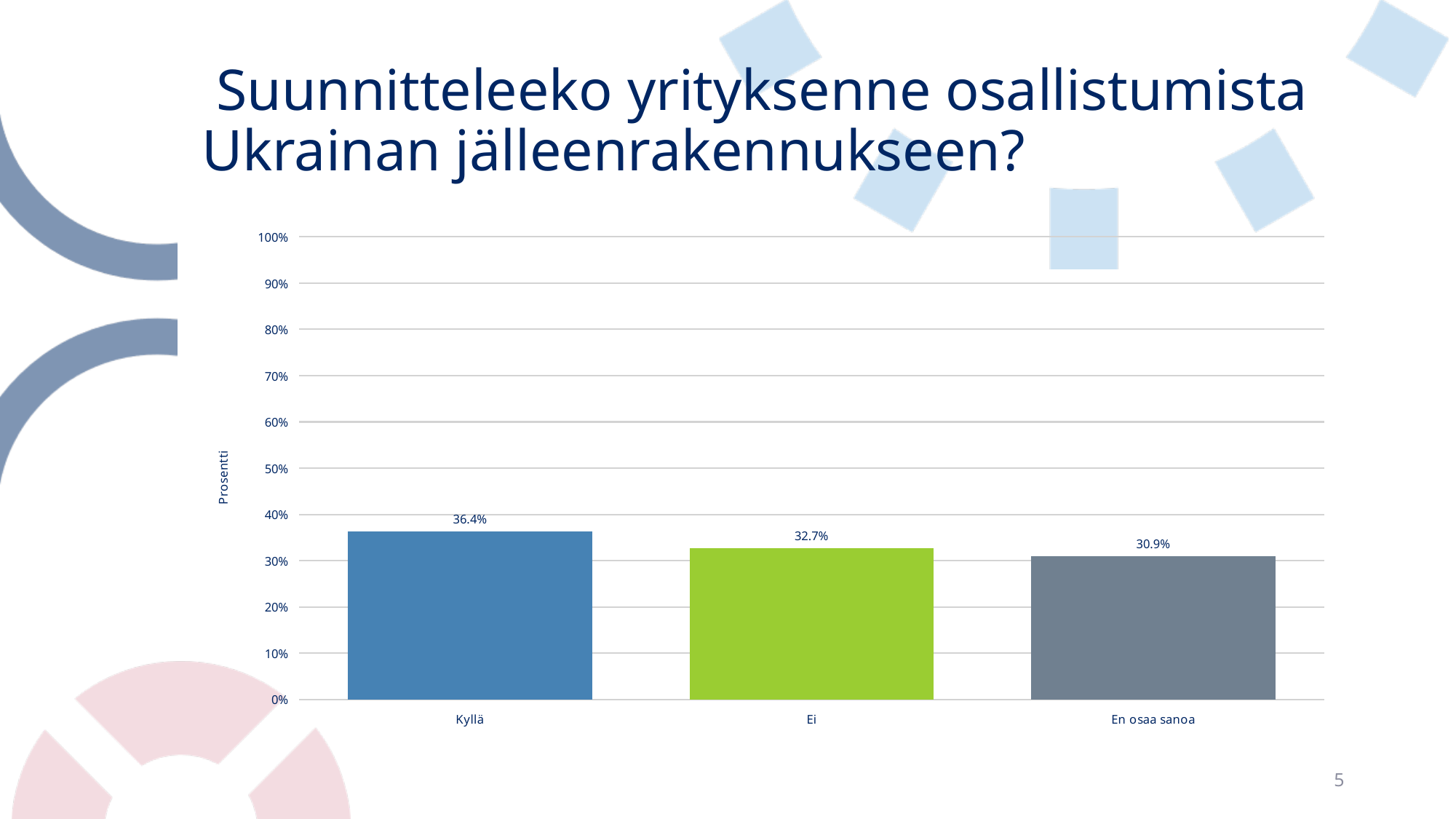
What is the difference between the values for Ei and En osaa sanoa? 1.8% Is the value for Kyllä greater or less than 40%? less Which category has the lowest value? En osaa sanoa What is the label of the vertical axis? Prosentti What kind of chart is shown on the slide? bar chart Which category has the highest value? Kyllä What is the difference between the values for Kyllä and Ei? 3.7% What is the value for Kyllä? 36.4% How many categories are shown on the x axis? 3 What is the value for Ei? 32.7% Which is larger, the value for Kyllä or the value for En osaa sanoa? Kyllä What is the value for En osaa sanoa? 30.9%